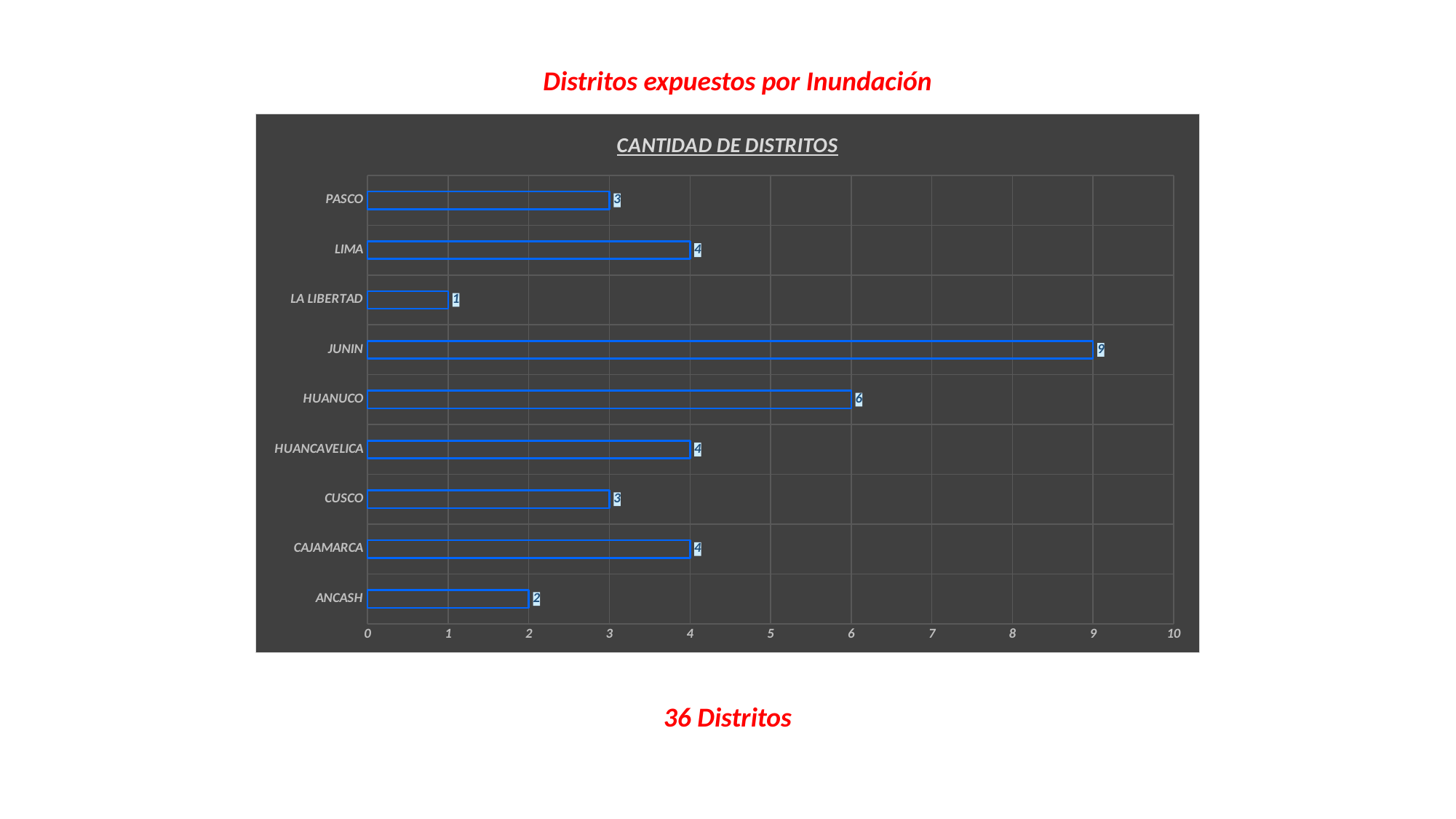
What is the difference between the values for JUNIN and HUANUCO? 3 What kind of chart is shown on the slide? bar chart What is the value for HUANUCO? 6 What is the value for ANCASH? 2 What is the title shown inside the chart area? CANTIDAD DE DISTRITOS Which is larger, the value for LIMA or the value for PASCO? LIMA Which category has the highest value? JUNIN Is the value for HUANUCO greater or less than 5? greater What is the value for JUNIN? 9 Which category has the lowest value? LA LIBERTAD What is the value for LA LIBERTAD? 1 How many categories are shown in the chart? 9